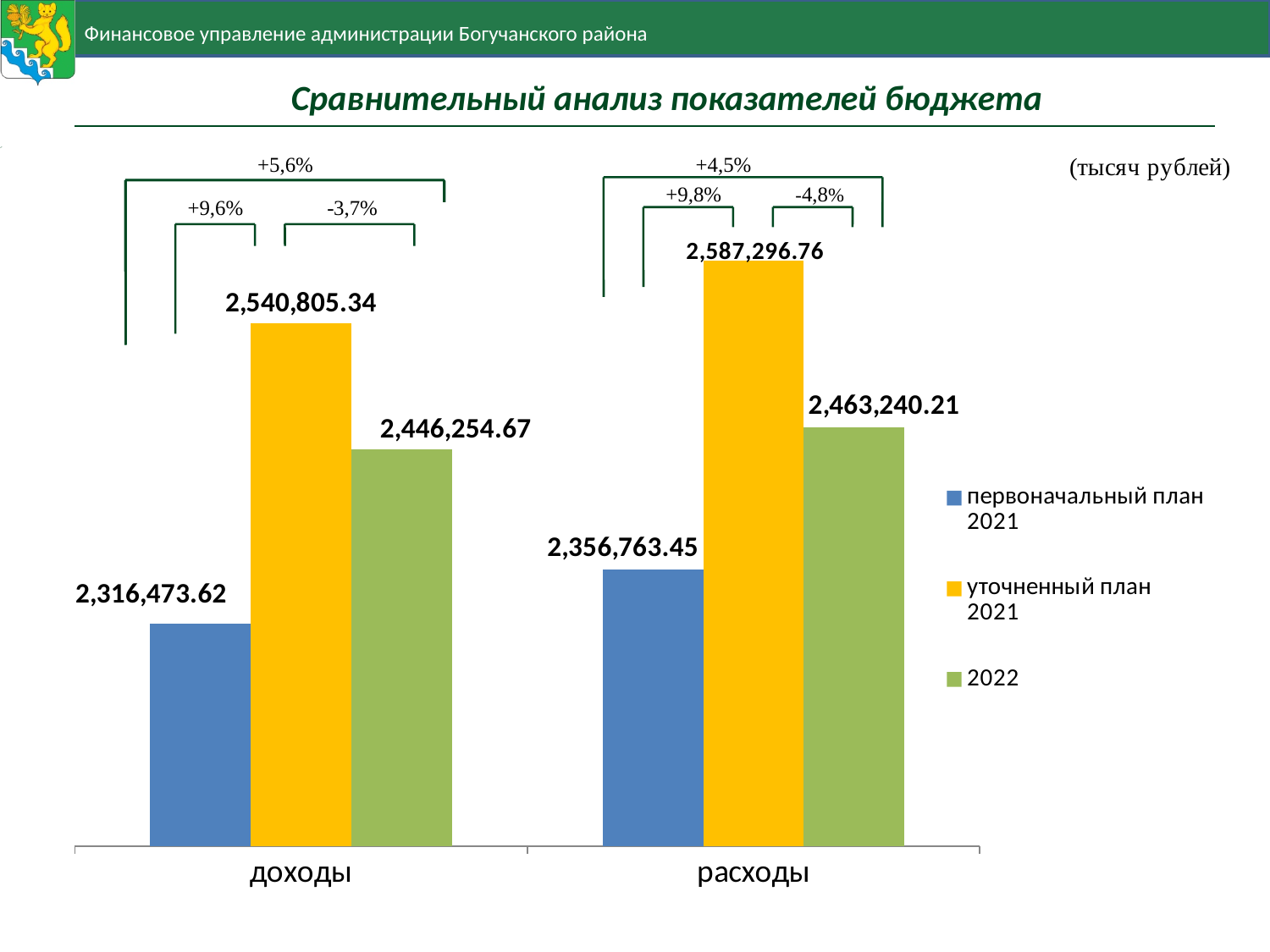
How many series does the legend list? 3 What is the value of 2022 for доходы? 2,446,254.67 Which series has the highest value for расходы? уточненный план 2021 How many categories are shown on the x axis? 2 What is the value of первоначальный план 2021 for доходы? 2,316,473.62 What is the difference between уточненный план 2021 and первоначальный план 2021 for доходы? 224,331.72 What unit is stated for the values on the chart? тысяч рублей Which is larger: the 2022 value for доходы or the 2022 value for расходы? расходы What is the value of уточненный план 2021 for расходы? 2,587,296.76 Which series has the lowest value for доходы? первоначальный план 2021 What is the value of 2022 for расходы? 2,463,240.21 What kind of chart is shown on the slide? bar chart